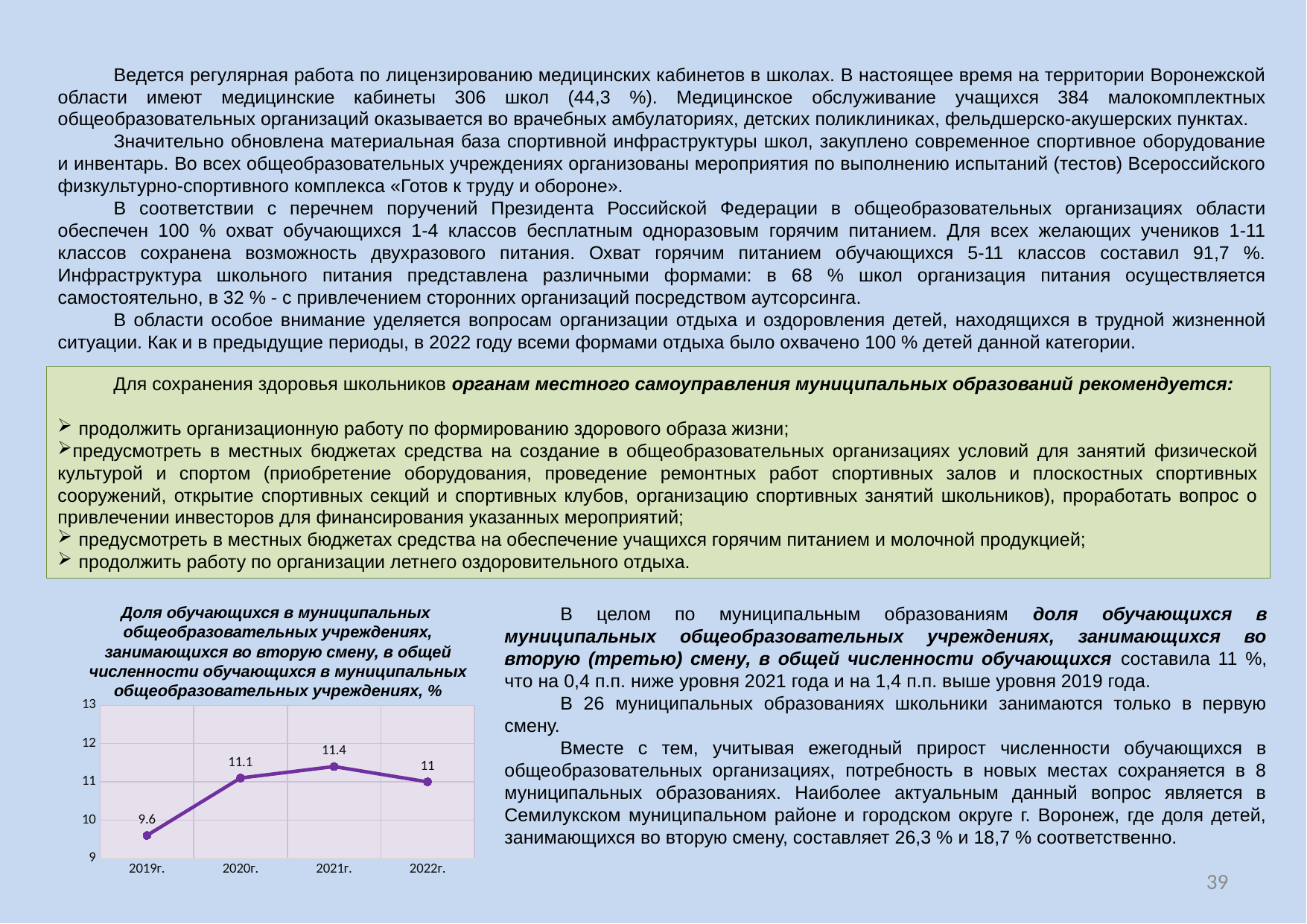
What kind of chart is shown on the slide? line chart What is the difference between the values for 2020г. and 2022г.? 0.1 What is the value for 2021г. on the chart? 11.4 Which is larger, the value for 2020г. or the value for 2019г.? 2020г. What is the value for 2022г. on the chart? 11 How many years are plotted on the chart? 4 Which year has the highest value on the chart? 2021г. What is the value for 2019г. on the chart? 9.6 Does the value rise or fall from 2021г. to 2022г.? fall Is the value for 2019г. greater or less than 10? less Which year has the lowest value on the chart? 2019г. What is the difference between the values for 2021г. and 2019г.? 1.8